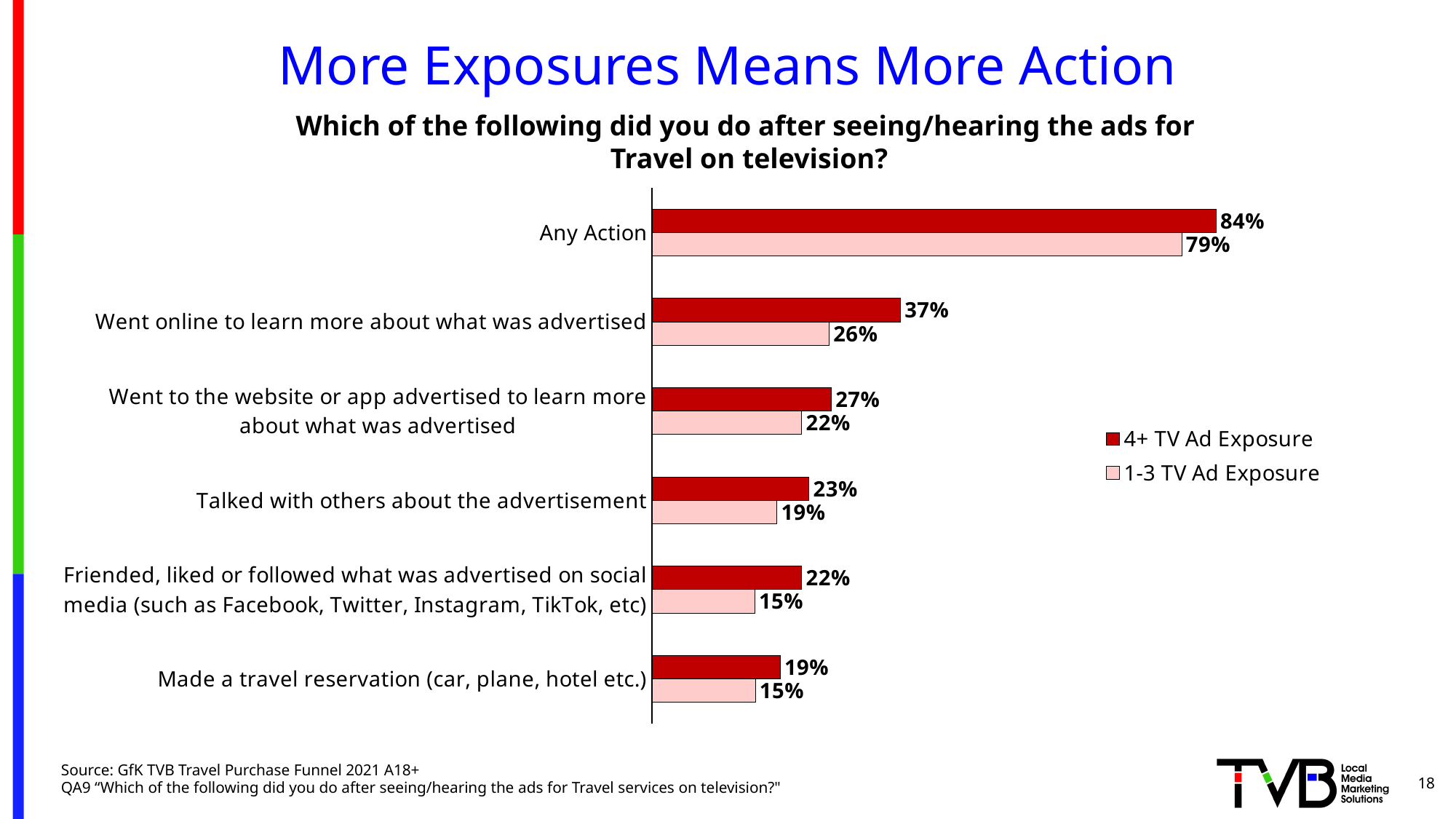
What percentage of the 1-3 TV Ad Exposure group went online to learn more about what was advertised? 26% What is the value for 'Made a travel reservation (car, plane, hotel etc.)' in the 4+ TV Ad Exposure series? 19% What is the difference between the two series for 'Friended, liked or followed what was advertised on social media'? 7 percentage points What colour represents the 1-3 TV Ad Exposure series? Light pink Which category has the lowest value for the 4+ TV Ad Exposure series? Made a travel reservation (car, plane, hotel etc.) What is the difference between the 4+ TV Ad Exposure and 1-3 TV Ad Exposure values for 'Went online to learn more about what was advertised'? 11 percentage points How many categories are shown on the chart? 6 How many series does the legend list? 2 What kind of chart is shown on the slide? Bar chart For 'Talked with others about the advertisement', which series has the larger value? 4+ TV Ad Exposure Which category has the highest value for the 1-3 TV Ad Exposure series? Any Action What percentage of the 4+ TV Ad Exposure group took Any Action? 84%